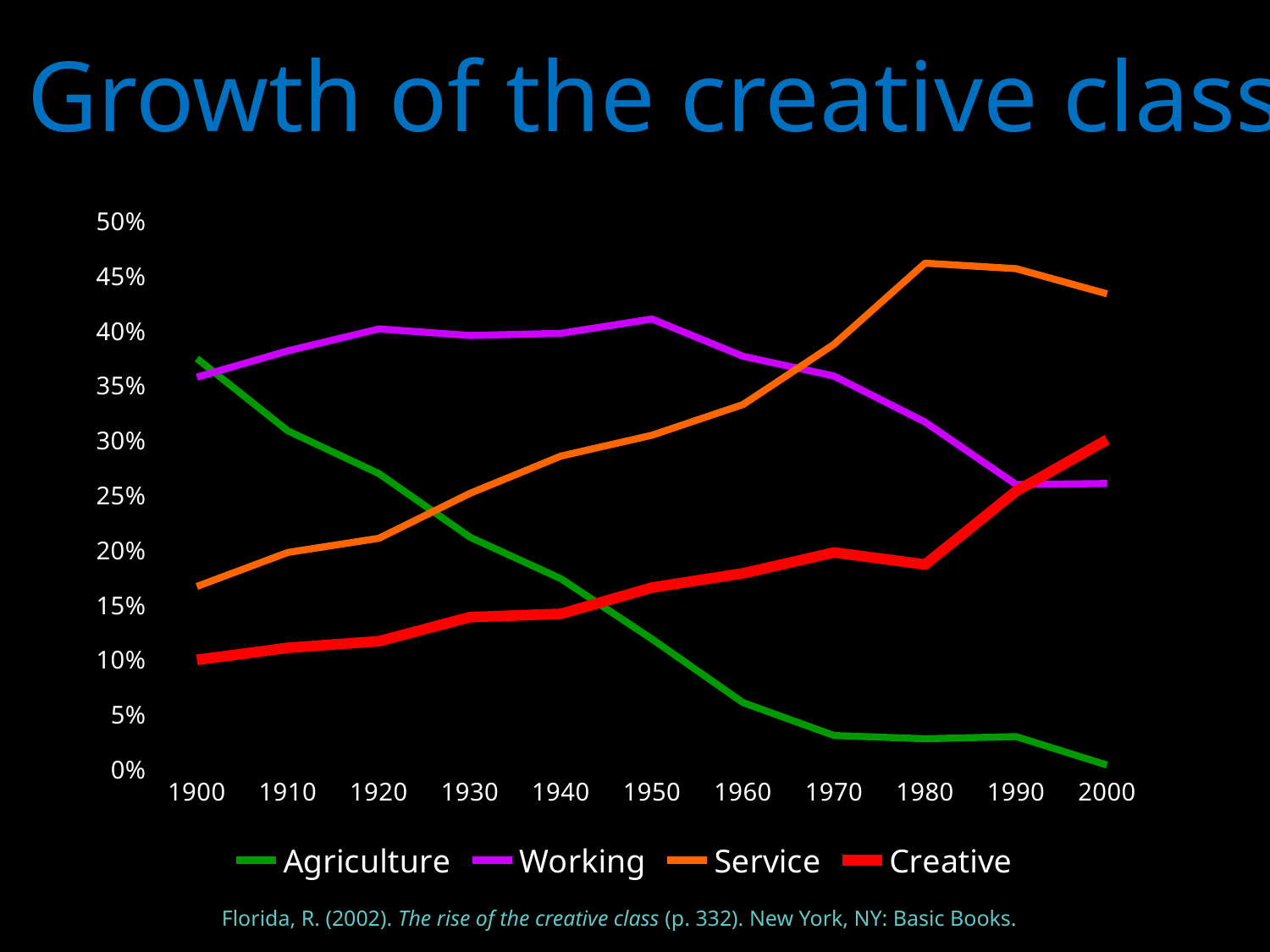
Is the value for Creative in 2000 greater or less than 25%? greater Which series has the highest value in 1950? Working Is the value for Working in 1920 greater or less than 35%? greater Is the value for Service in 1980 greater or less than 40%? greater Does the Agriculture line rise or fall from 1900 to 2000? fall In 2000, which is larger, the Service value or the Working value? Service Which series has the lowest value in 2000? Agriculture What kind of chart is shown on the slide? line chart How many years are marked along the x axis? 11 Does the Service line rise or fall from 1900 to 1980? rise How many series does the legend list? 4